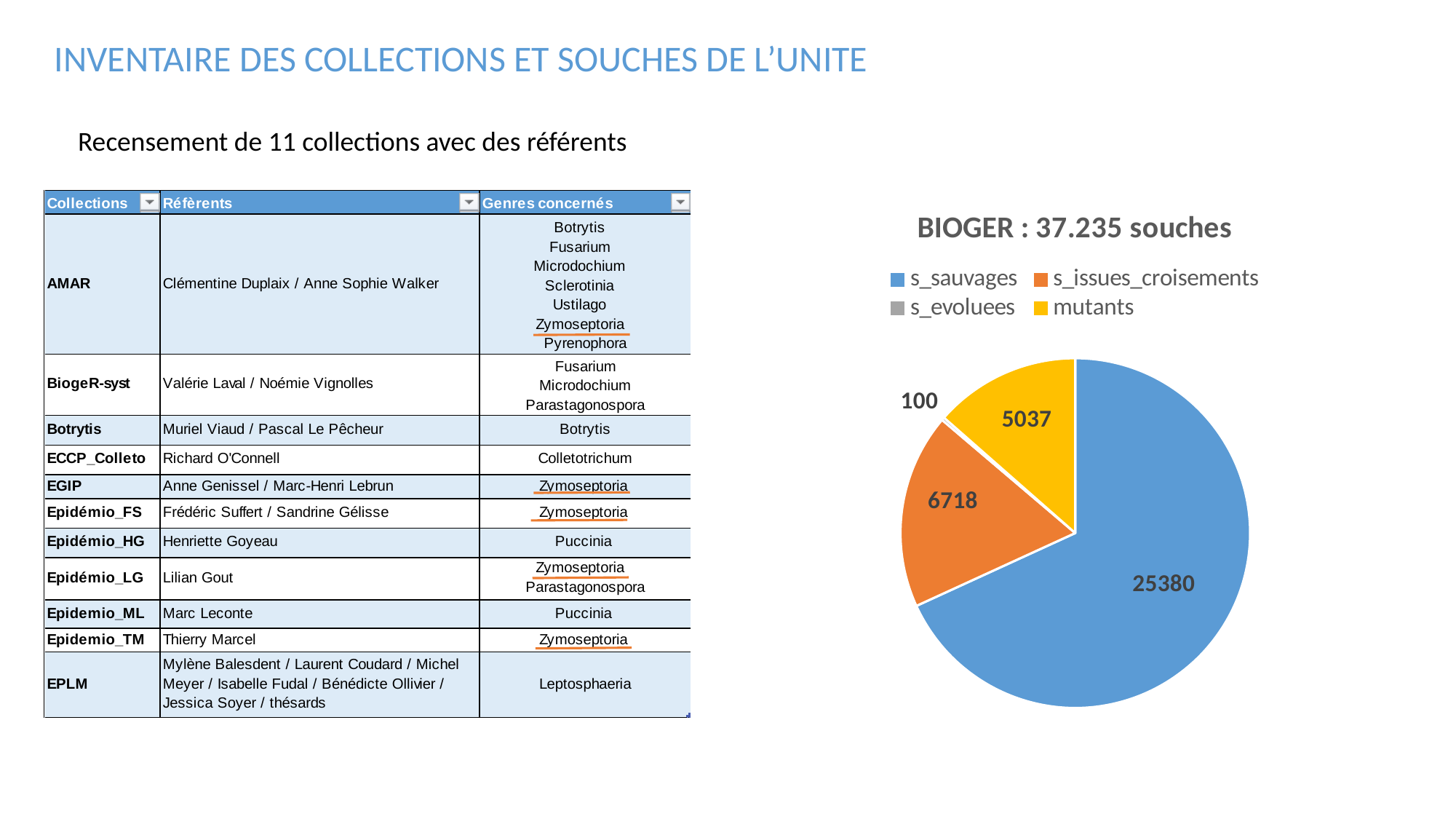
What is the value for s_issues_croisements in the pie chart? 6718 Which category has the largest slice in the pie chart? s_sauvages Which colour represents mutants in the pie chart? yellow What is the value for s_evoluees in the pie chart? 100 How many series does the legend of the pie chart list? 4 What is the value for s_sauvages in the pie chart? 25380 What is the title of the pie chart? BIOGER : 37.235 souches What kind of chart is shown on the slide? pie chart Which is larger in the pie chart, s_issues_croisements or mutants? s_issues_croisements What is the difference between the values for s_issues_croisements and mutants in the pie chart? 1681 Which category has the smallest slice in the pie chart? s_evoluees What is the value for mutants in the pie chart? 5037